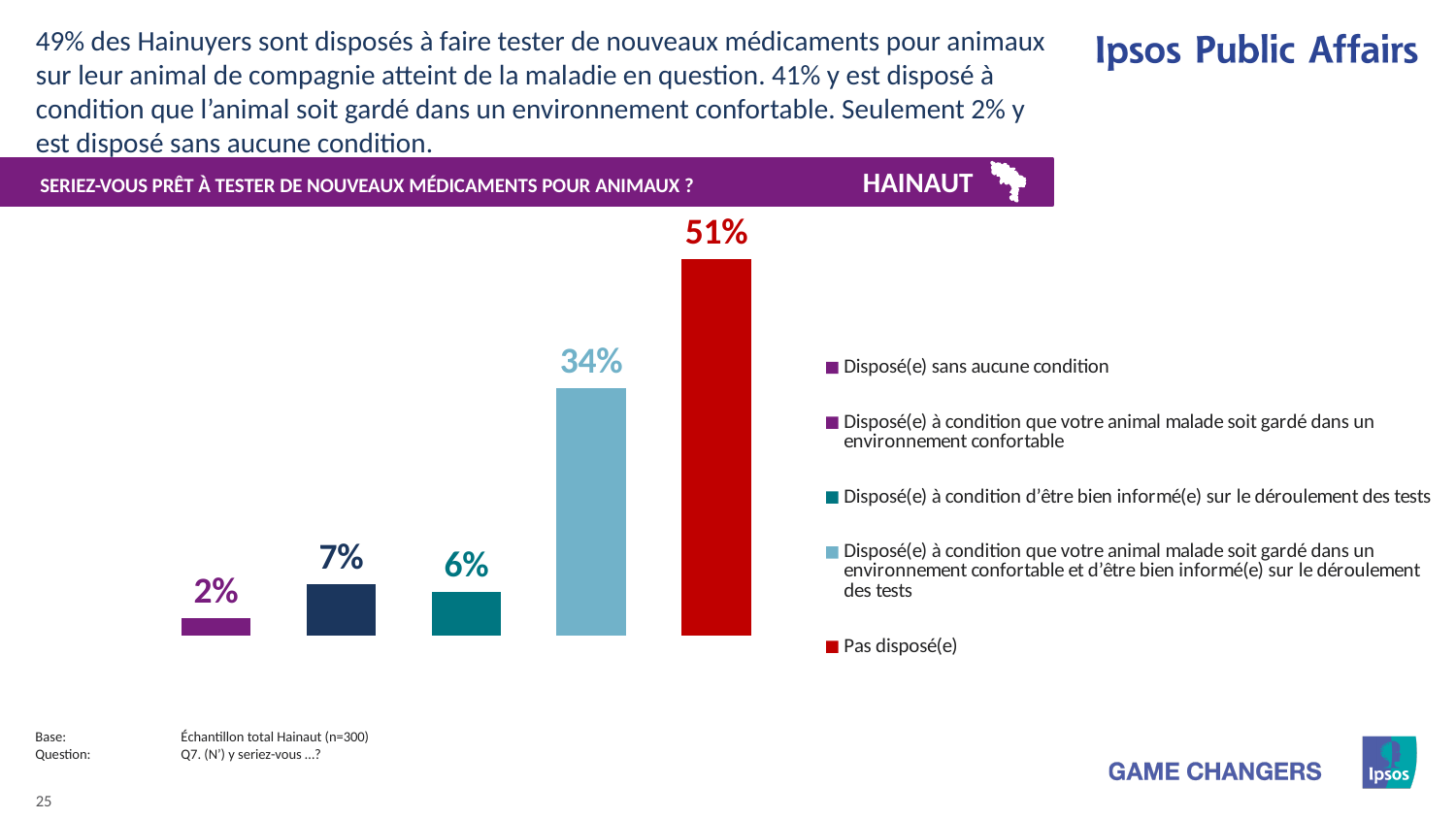
How many entries does the legend list? 5 How many bars are shown in the chart? 5 What is the value for 'Disposé(e) à condition d'être bien informé(e) sur le déroulement des tests'? 6% What colour is the bar for 'Pas disposé(e)'? Red What is the value for 'Disposé(e) à condition que votre animal malade soit gardé dans un environnement confortable'? 7% What is the difference between 'Pas disposé(e)' and the category with both conditions (environnement confortable et bien informé(e))? 17% What type of chart is shown on the slide? Bar chart Which category has the lowest value? Disposé(e) sans aucune condition Which is larger: 'Disposé(e) à condition que votre animal malade soit gardé dans un environnement confortable' or 'Disposé(e) à condition d'être bien informé(e) sur le déroulement des tests'? Disposé(e) à condition que votre animal malade soit gardé dans un environnement confortable What percentage of respondents are 'Disposé(e) sans aucune condition'? 2% Which category has the highest value? Pas disposé(e) What percentage of respondents are 'Pas disposé(e)'? 51%